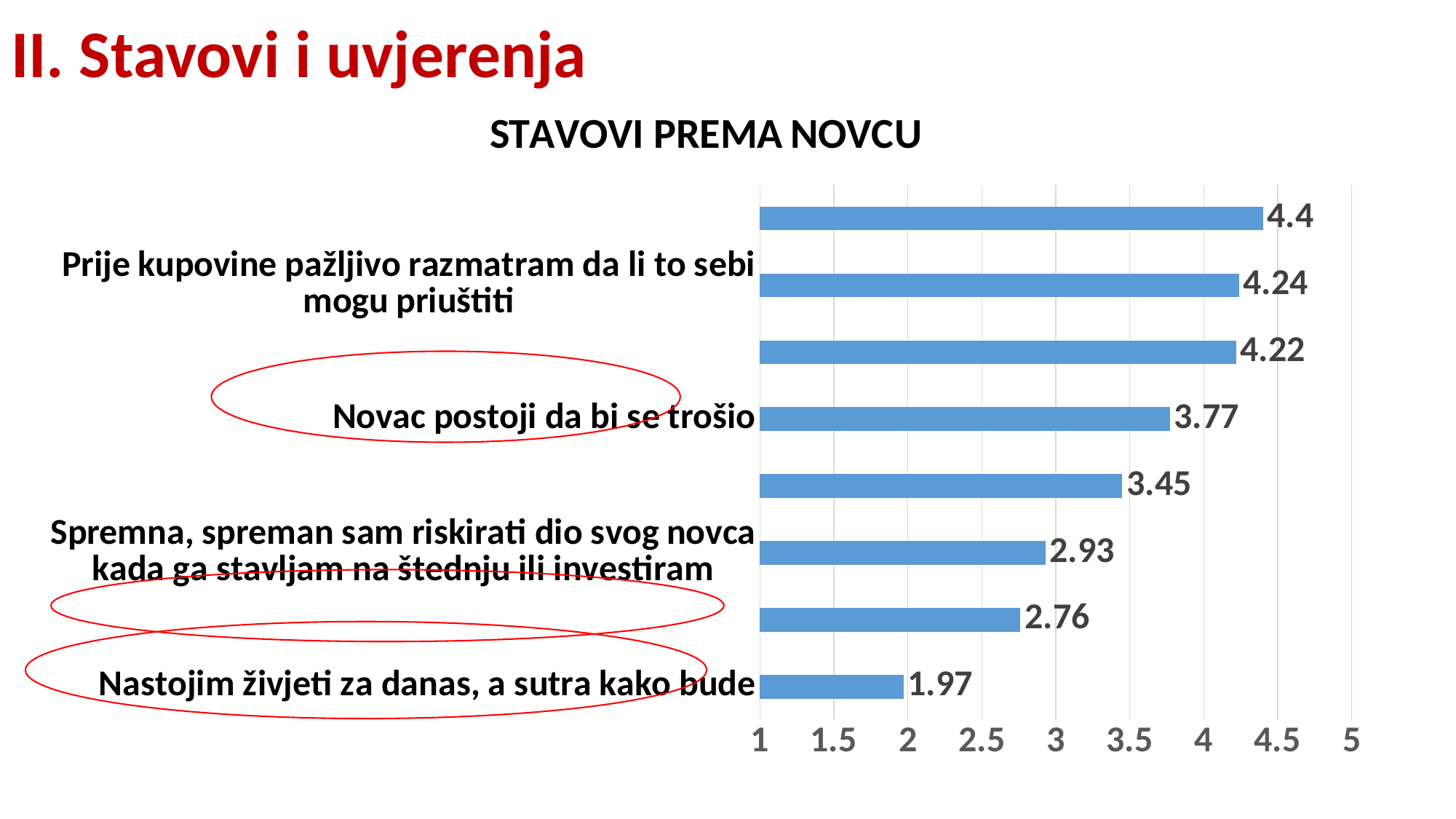
What is the value for "Prije kupovine pažljivo razmatram da li to sebi mogu priuštiti"? 4.24 Which has a larger value: "Novac postoji da bi se trošio" or "Spremna, spreman sam riskirati dio svog novca kada ga stavljam na štednju ili investiram"? Novac postoji da bi se trošio Is the value for "Nastojim živjeti za danas, a sutra kako bude" greater or less than 2? less How many bars does the chart contain? 8 What is the value for "Nastojim živjeti za danas, a sutra kako bude"? 1.97 What is the value for "Spremna, spreman sam riskirati dio svog novca kada ga stavljam na štednju ili investiram"? 2.93 What is the title of the chart? STAVOVI PREMA NOVCU Which statement has the lowest value in the chart? Nastojim živjeti za danas, a sutra kako bude What is the highest value shown in the chart? 4.4 What kind of chart is shown on the slide? Bar chart What is the difference between the values for "Prije kupovine pažljivo razmatram da li to sebi mogu priuštiti" and "Novac postoji da bi se trošio"? 0.47 What is the value for "Novac postoji da bi se trošio"? 3.77